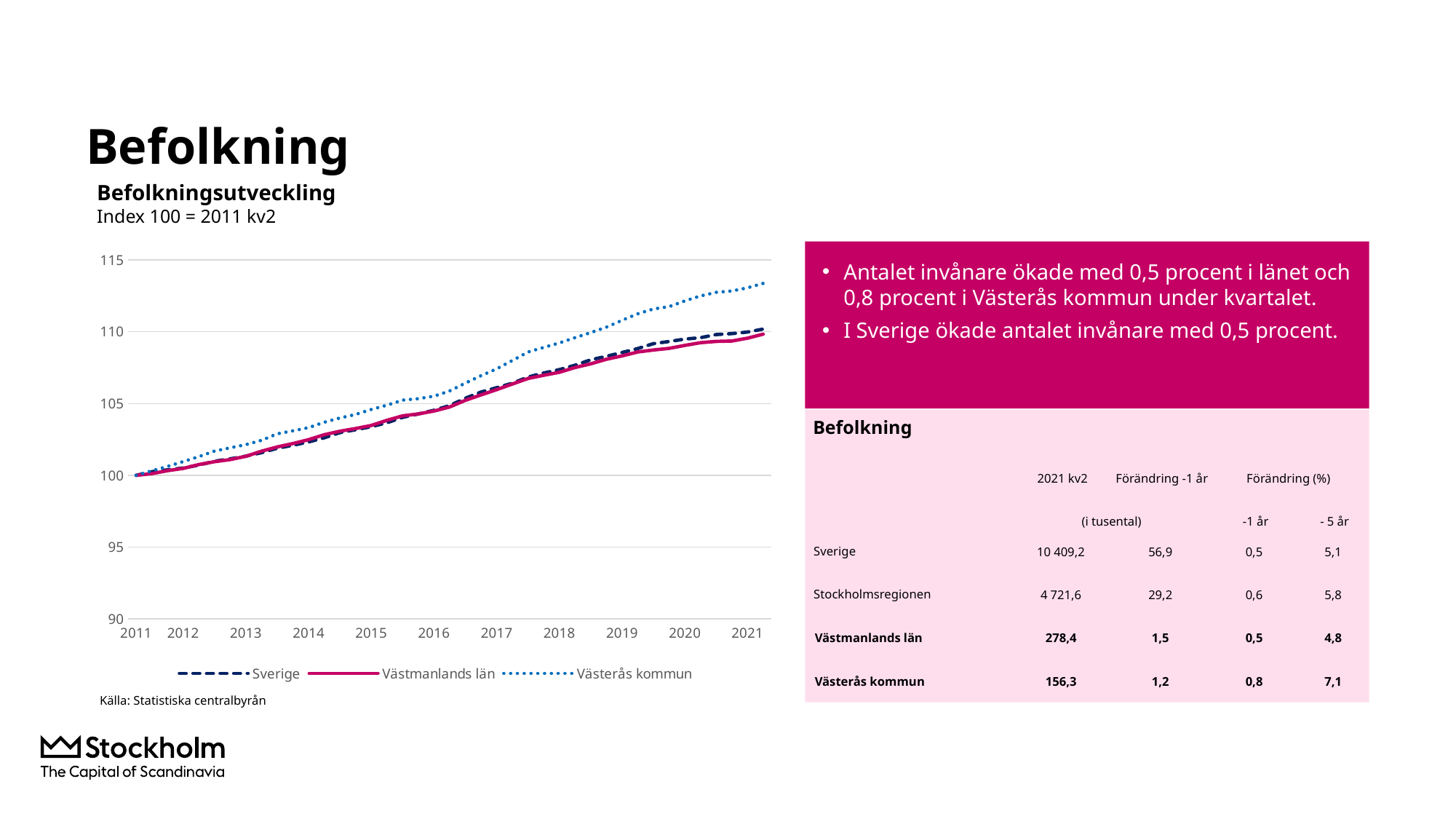
What is the title of the chart? Befolkningsutveckling What kind of chart is shown on the slide? line chart Do the index values rise or fall from 2011 to 2021? rise Is the value for Västerås kommun in 2020 greater or less than 110? greater Is the value for Västmanlands län in 2014 greater or less than 105? less Which is larger in 2018, the value for Västerås kommun or the value for Västmanlands län? Västerås kommun How many years are labelled on the x axis? 11 Which series has the highest index value in 2021? Västerås kommun Is the value for Västerås kommun in 2021 greater or less than 110? greater What is the index value for all three series in 2011? 100 How many series does the chart legend list? 3